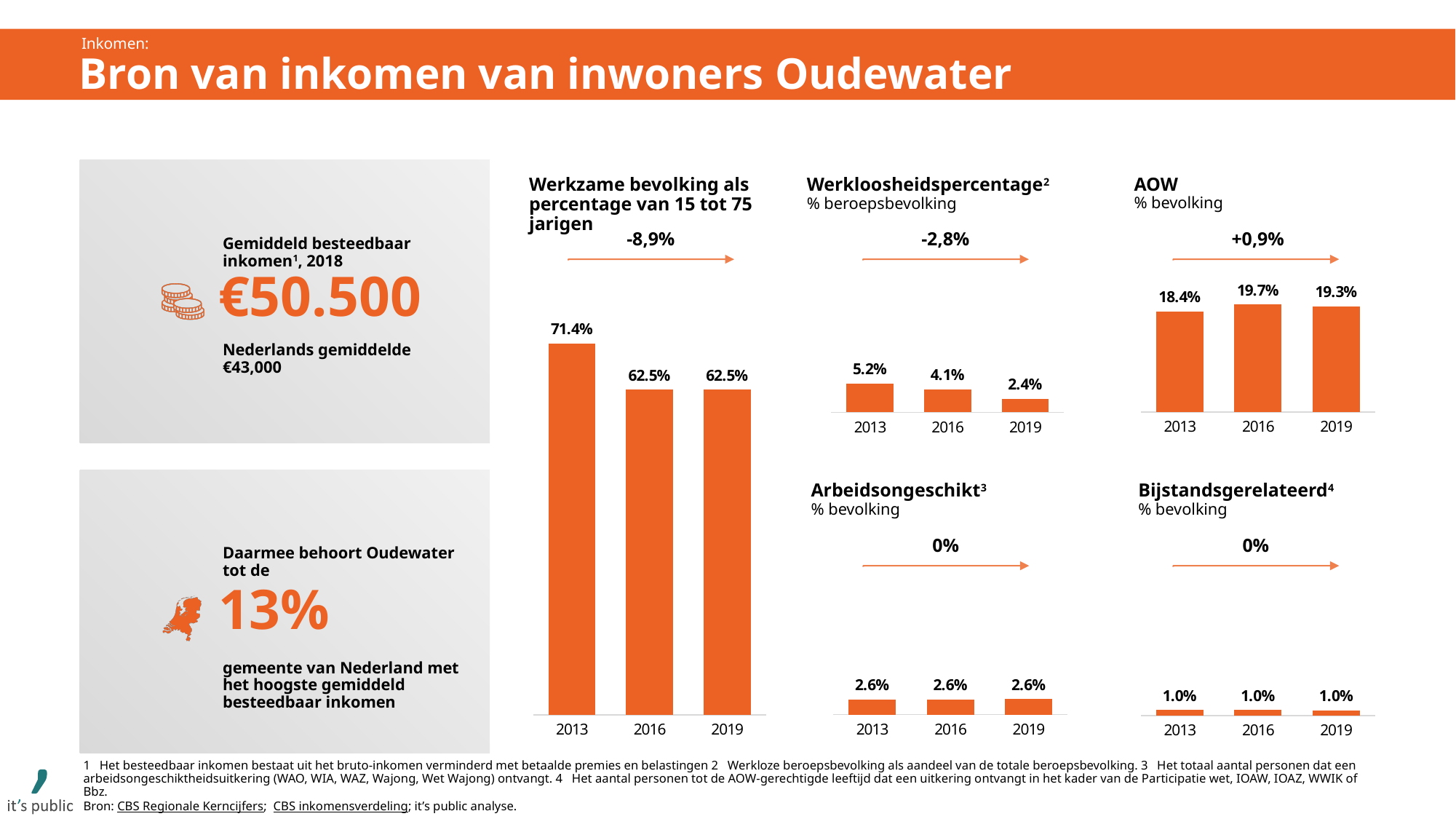
In the 'Arbeidsongeschikt' chart, what is the value for 2019? 2.6% In the 'AOW' chart, what is the value for 2013? 18.4% In the 'Bijstandsgerelateerd' chart, what is the value for 2016? 1.0% In the 'Werkzame bevolking als percentage van 15 tot 75 jarigen' chart, what is the value for 2019? 62.5% How many years are shown on the x axis of the 'Werkloosheidspercentage' chart? 3 In the 'AOW' chart, which year has the highest value? 2016 In the 'Werkloosheidspercentage' chart, what is the difference between the 2013 and 2019 values? 2.8% What type of chart is the 'AOW' chart? bar chart In the 'Werkloosheidspercentage' chart, which year has the lowest value? 2019 In the 'AOW' chart, is the value for 2019 larger or smaller than the value for 2013? larger In the 'Werkloosheidspercentage' chart, what is the value for 2016? 4.1% In the 'Werkzame bevolking als percentage van 15 tot 75 jarigen' chart, what is the value for 2013? 71.4%